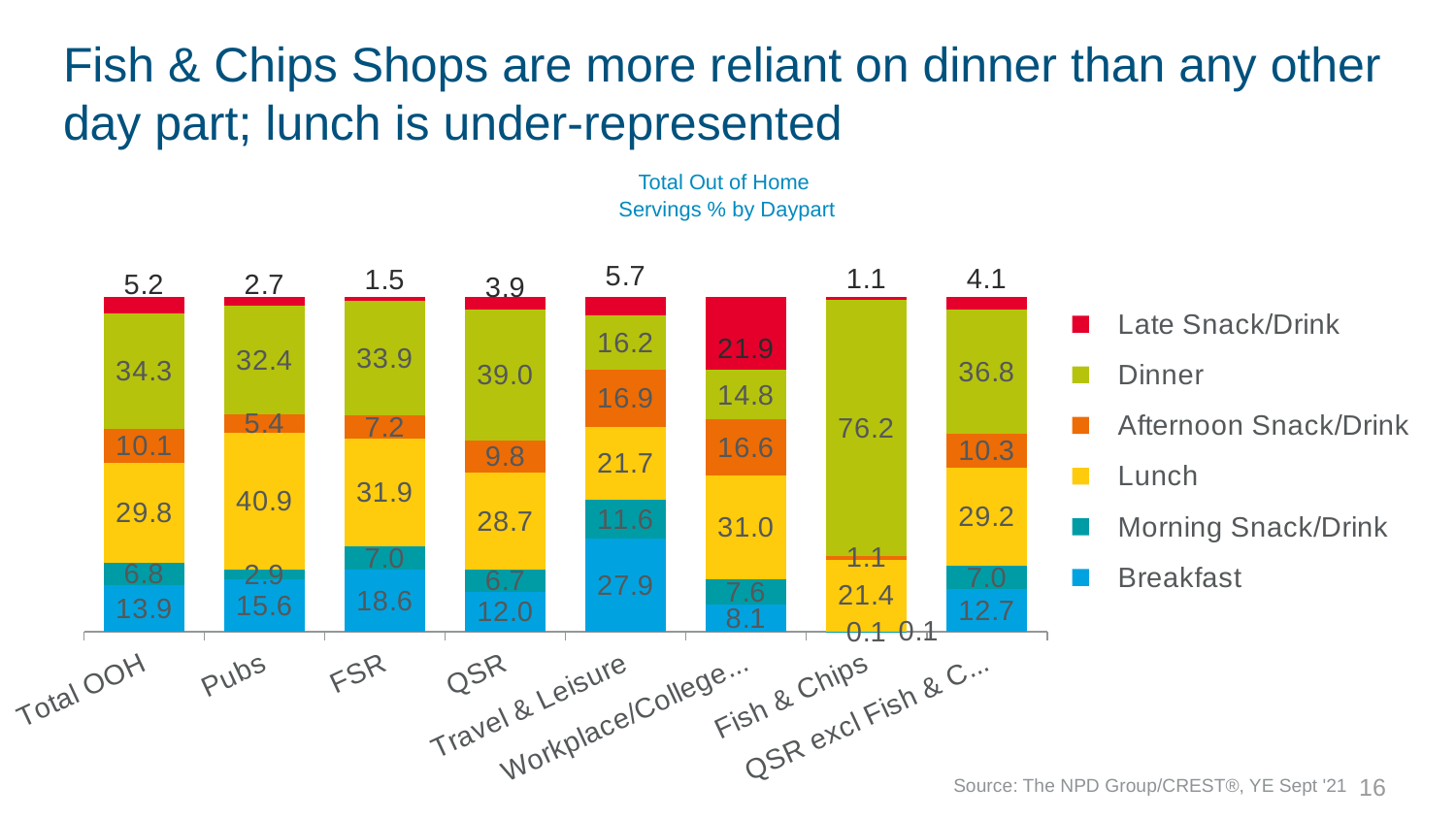
Which category has the lowest Breakfast value? Fish & Chips How many series does the legend list? 6 What is the Afternoon Snack/Drink value for QSR? 9.8 What kind of chart is shown on the slide? Stacked bar chart What is the difference between the Dinner value for Fish & Chips and the Dinner value for Total OOH? 41.9 Which category has the highest Dinner value? Fish & Chips What is the Lunch value for Pubs? 40.9 Which category has the highest Lunch value? Pubs Which has the larger Breakfast value, FSR or Pubs? FSR How many categories are shown on the x axis? 8 What is the Breakfast value for Travel & Leisure? 27.9 What is the Dinner value for Fish & Chips? 76.2